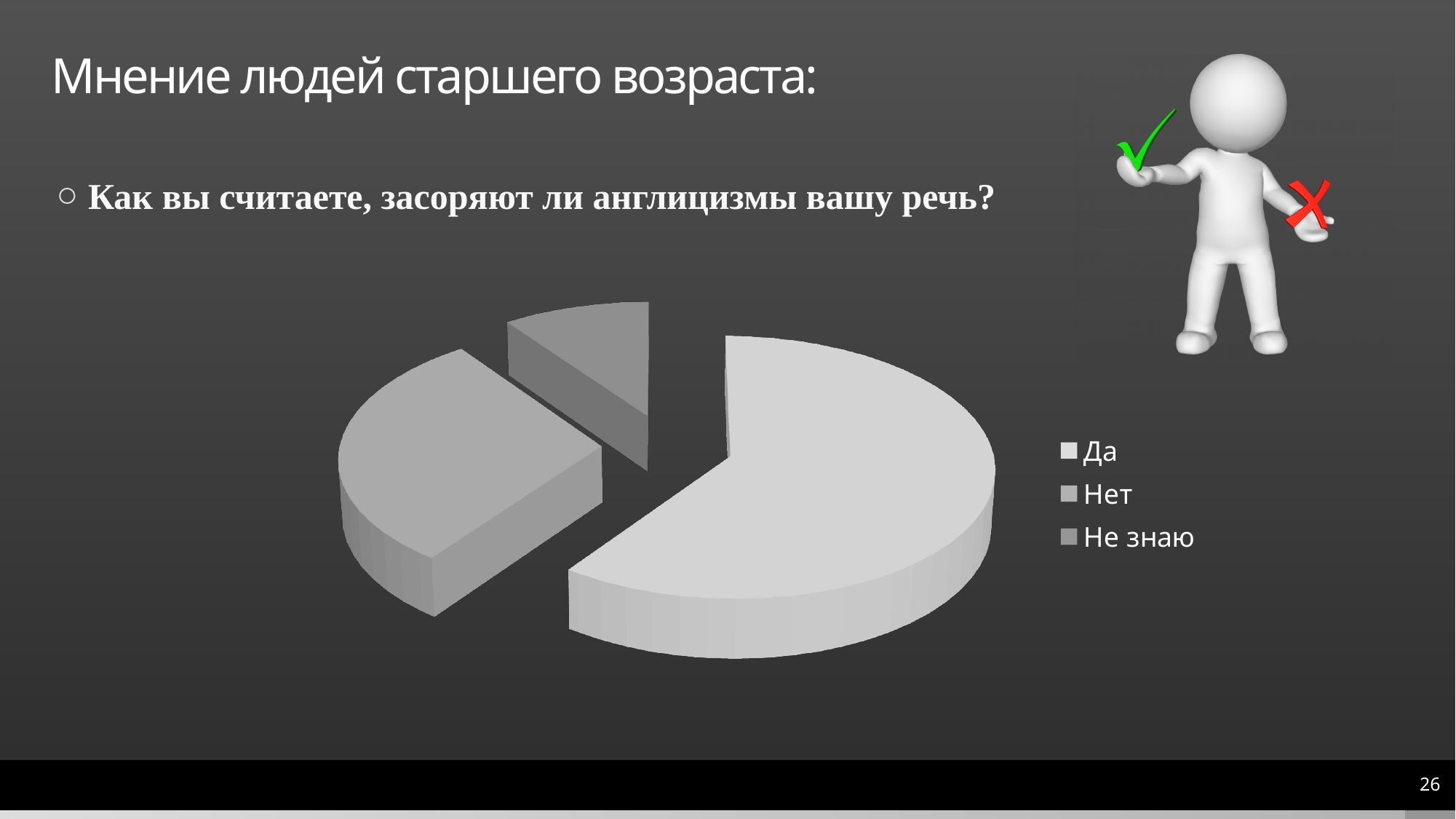
Which category has the largest slice in the pie chart? Да How many slices does the pie chart have? 3 What are the legend entries of the pie chart, in order from top to bottom? Да, Нет, Не знаю What survey question does the pie chart on the slide illustrate? Как вы считаете, засоряют ли англицизмы вашу речь? Which slice is larger in the pie chart, Нет or Не знаю? Нет Which slice is larger in the pie chart, Да or Нет? Да What kind of chart is shown on the slide? pie chart Which slice is smaller in the pie chart, Да or Не знаю? Не знаю How many entries does the legend of the pie chart list? 3 Which category has the smallest slice in the pie chart? Не знаю